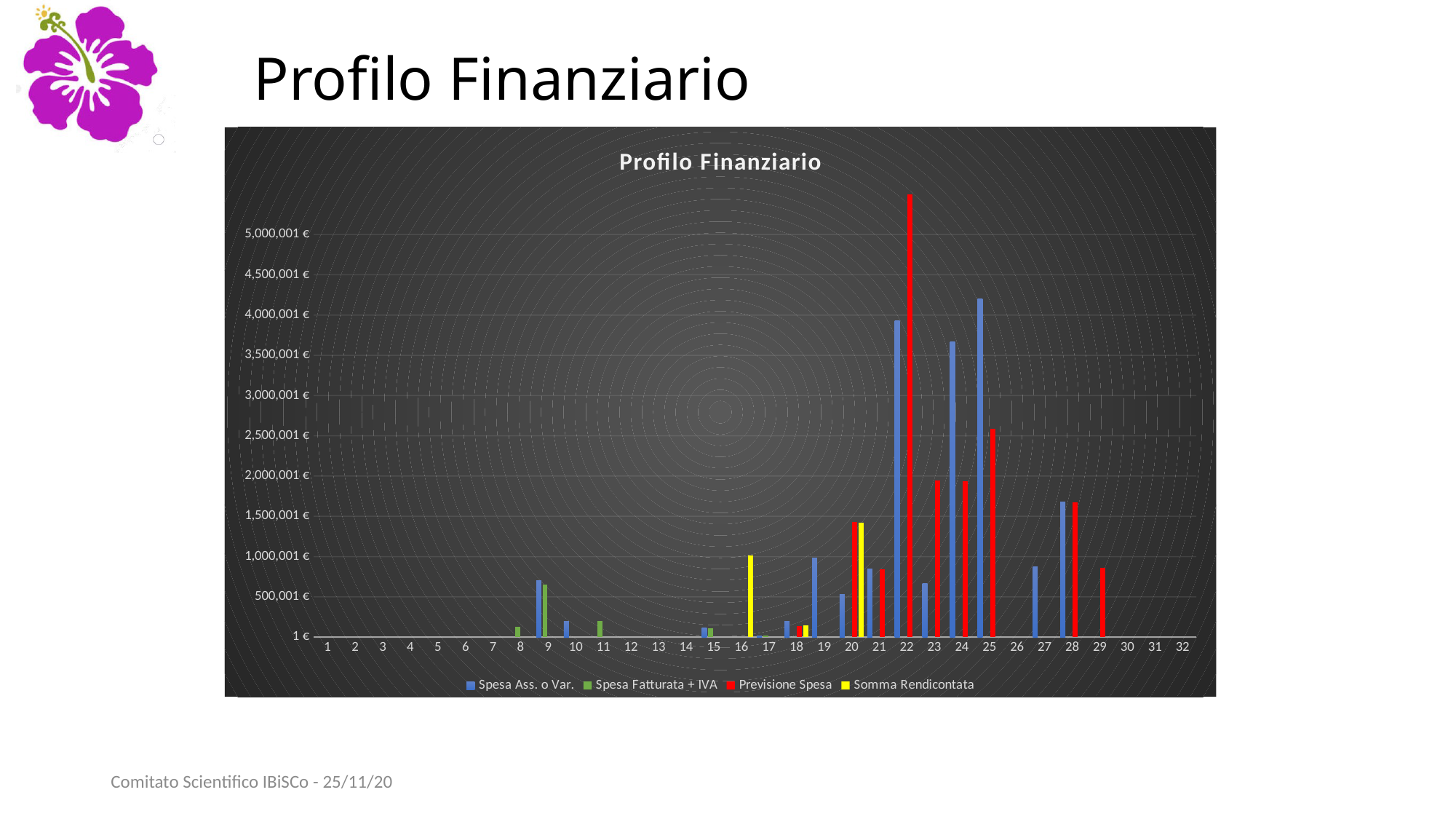
At which category does the Previsione Spesa series reach its highest value? 22 How many categories are shown on the x axis of the chart? 32 What kind of chart is shown on the slide? bar chart At category 25, which is larger: Spesa Ass. o Var. or Previsione Spesa? Spesa Ass. o Var. At category 22, which is larger: Spesa Ass. o Var. or Previsione Spesa? Previsione Spesa At which category does the Spesa Ass. o Var. series reach its highest value? 25 What is the title of the chart? Profilo Finanziario Which colour represents the series Previsione Spesa in the chart? red Is the Previsione Spesa value at category 22 greater or less than 5,000,001 €? greater How many series does the legend of the chart list? 4 Is the Spesa Ass. o Var. value at category 25 greater or less than 4,000,001 €? greater